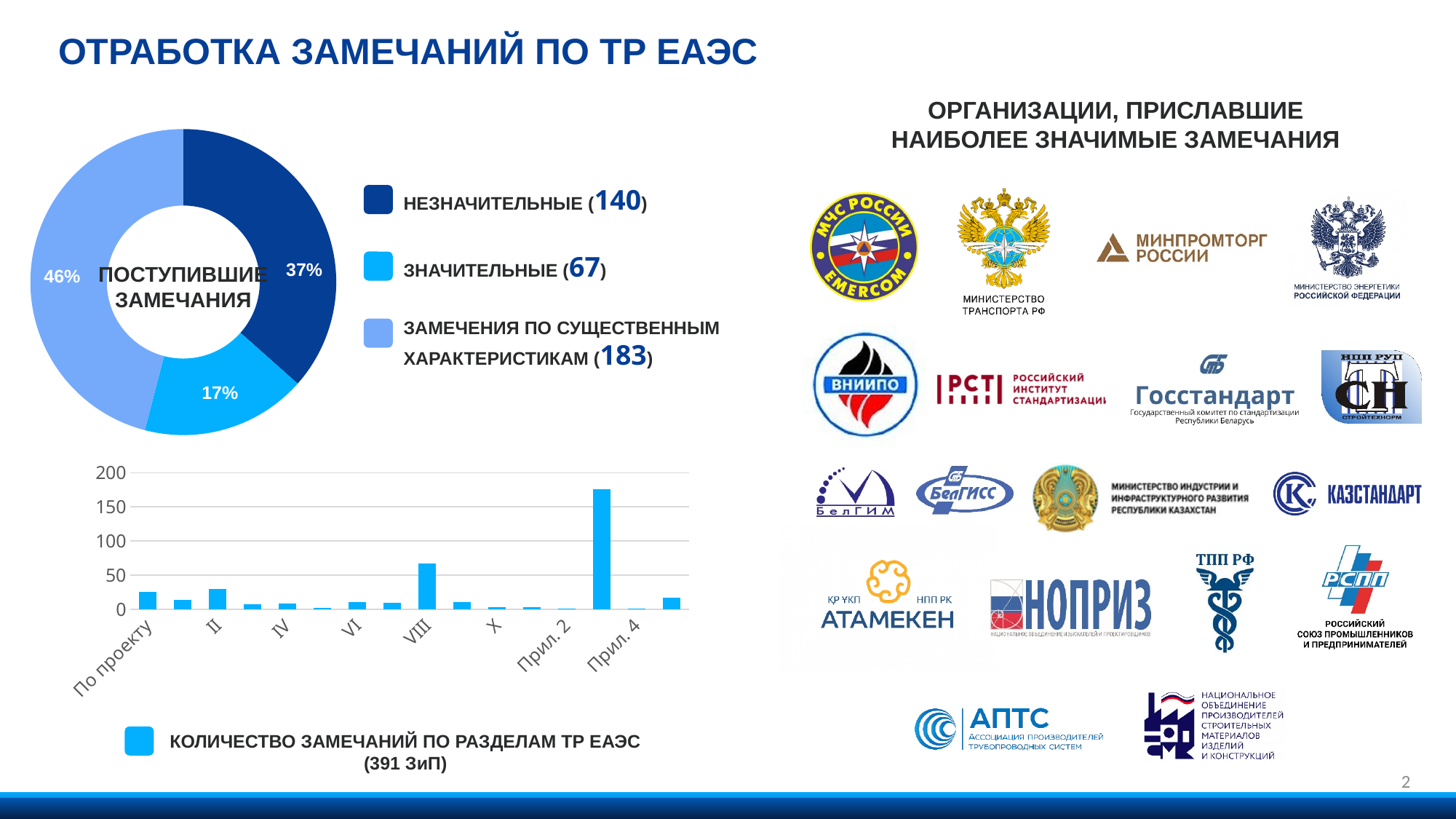
In the doughnut chart ПОСТУПИВШИЕ ЗАМЕЧАНИЯ, which category has the smallest share? ЗНАЧИТЕЛЬНЫЕ In the bar chart КОЛИЧЕСТВО ЗАМЕЧАНИЙ ПО РАЗДЕЛАМ ТР ЕАЭС, is the value for VIII greater or less than 50? greater In the doughnut chart ПОСТУПИВШИЕ ЗАМЕЧАНИЯ, what share of the comments are ЗАМЕЧЕНИЯ ПО СУЩЕСТВЕННЫМ ХАРАКТЕРИСТИКАМ? 46% In the doughnut chart ПОСТУПИВШИЕ ЗАМЕЧАНИЯ, what share of the comments are НЕЗНАЧИТЕЛЬНЫЕ? 37% In the doughnut chart ПОСТУПИВШИЕ ЗАМЕЧАНИЯ, how many comments are listed as ЗНАЧИТЕЛЬНЫЕ in the legend? 67 In the doughnut chart ПОСТУПИВШИЕ ЗАМЕЧАНИЯ, what share of the comments are ЗНАЧИТЕЛЬНЫЕ? 17% In the bar chart КОЛИЧЕСТВО ЗАМЕЧАНИЙ ПО РАЗДЕЛАМ ТР ЕАЭС, which is larger, the value for VIII or the value for II? VIII In the doughnut chart ПОСТУПИВШИЕ ЗАМЕЧАНИЯ, which category has the largest share? ЗАМЕЧЕНИЯ ПО СУЩЕСТВЕННЫМ ХАРАКТЕРИСТИКАМ In the doughnut chart ПОСТУПИВШИЕ ЗАМЕЧАНИЯ, what is the difference between the number of НЕЗНАЧИТЕЛЬНЫЕ and ЗНАЧИТЕЛЬНЫЕ comments? 73 What kind of chart is the chart КОЛИЧЕСТВО ЗАМЕЧАНИЙ ПО РАЗДЕЛАМ ТР ЕАЭС at the bottom left of the slide? bar chart In the doughnut chart ПОСТУПИВШИЕ ЗАМЕЧАНИЯ, how many comments are listed as НЕЗНАЧИТЕЛЬНЫЕ in the legend? 140 How many categories does the legend of the doughnut chart ПОСТУПИВШИЕ ЗАМЕЧАНИЯ list? 3